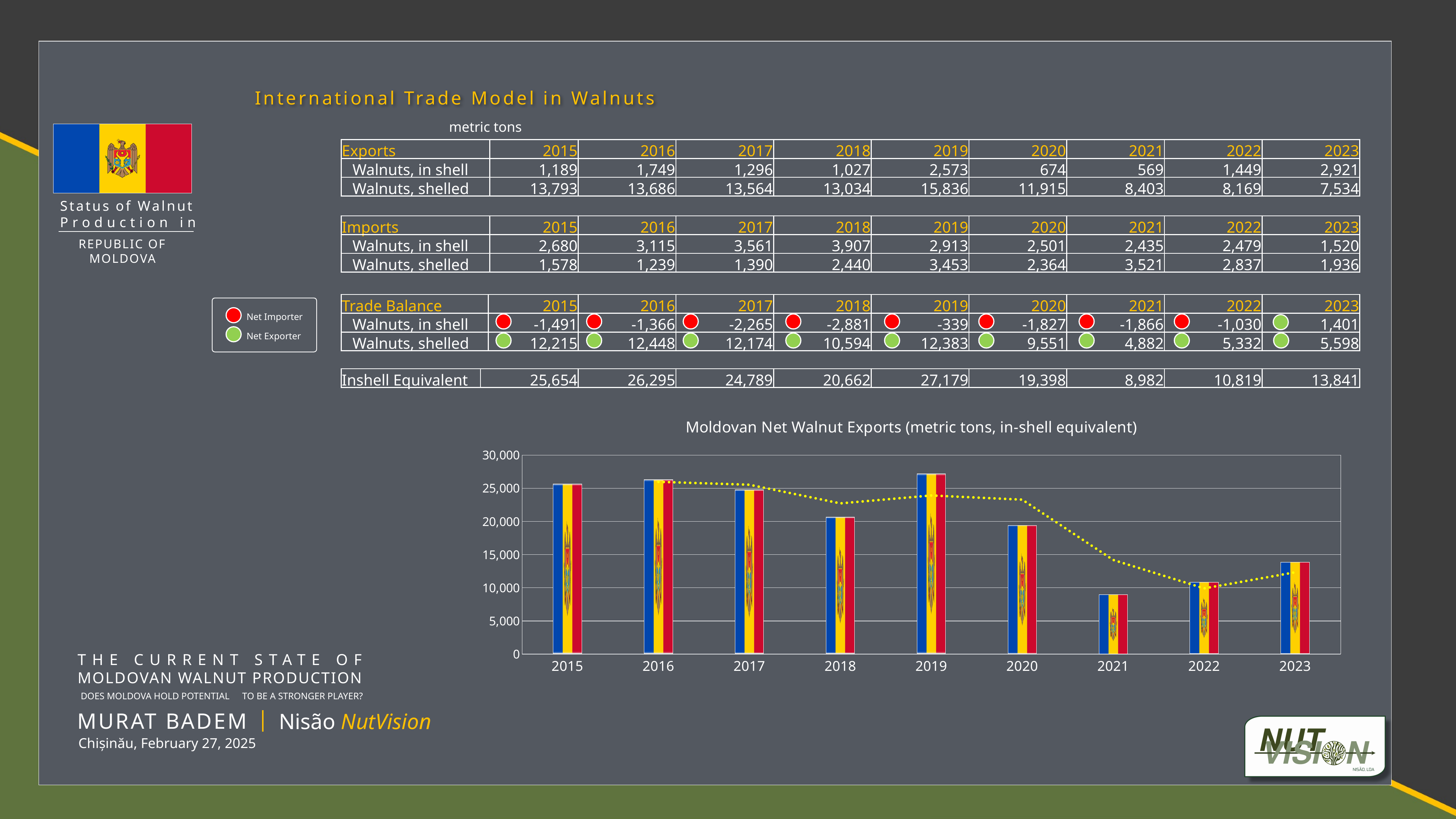
What kind of chart is shown at the bottom of the slide? bar chart In the Moldovan Net Walnut Exports chart, do the bars generally rise or fall from 2015 to 2021? fall How many years are plotted on the x axis of the Moldovan Net Walnut Exports chart? 9 What is the title of the chart at the bottom of the slide? Moldovan Net Walnut Exports (metric tons, in-shell equivalent) In the Moldovan Net Walnut Exports chart, is the value for 2019 greater or less than 25,000? greater In the Moldovan Net Walnut Exports chart, is the value for 2023 greater or less than 15,000? less In the Moldovan Net Walnut Exports chart, which bar is taller, 2019 or 2020? 2019 In the Moldovan Net Walnut Exports chart, is the value for 2021 greater or less than 10,000? less In the Moldovan Net Walnut Exports chart, which bar is taller, 2015 or 2021? 2015 In the Moldovan Net Walnut Exports chart, which bar is taller, 2022 or 2023? 2023 In the Moldovan Net Walnut Exports chart, which year has the lowest bar? 2021